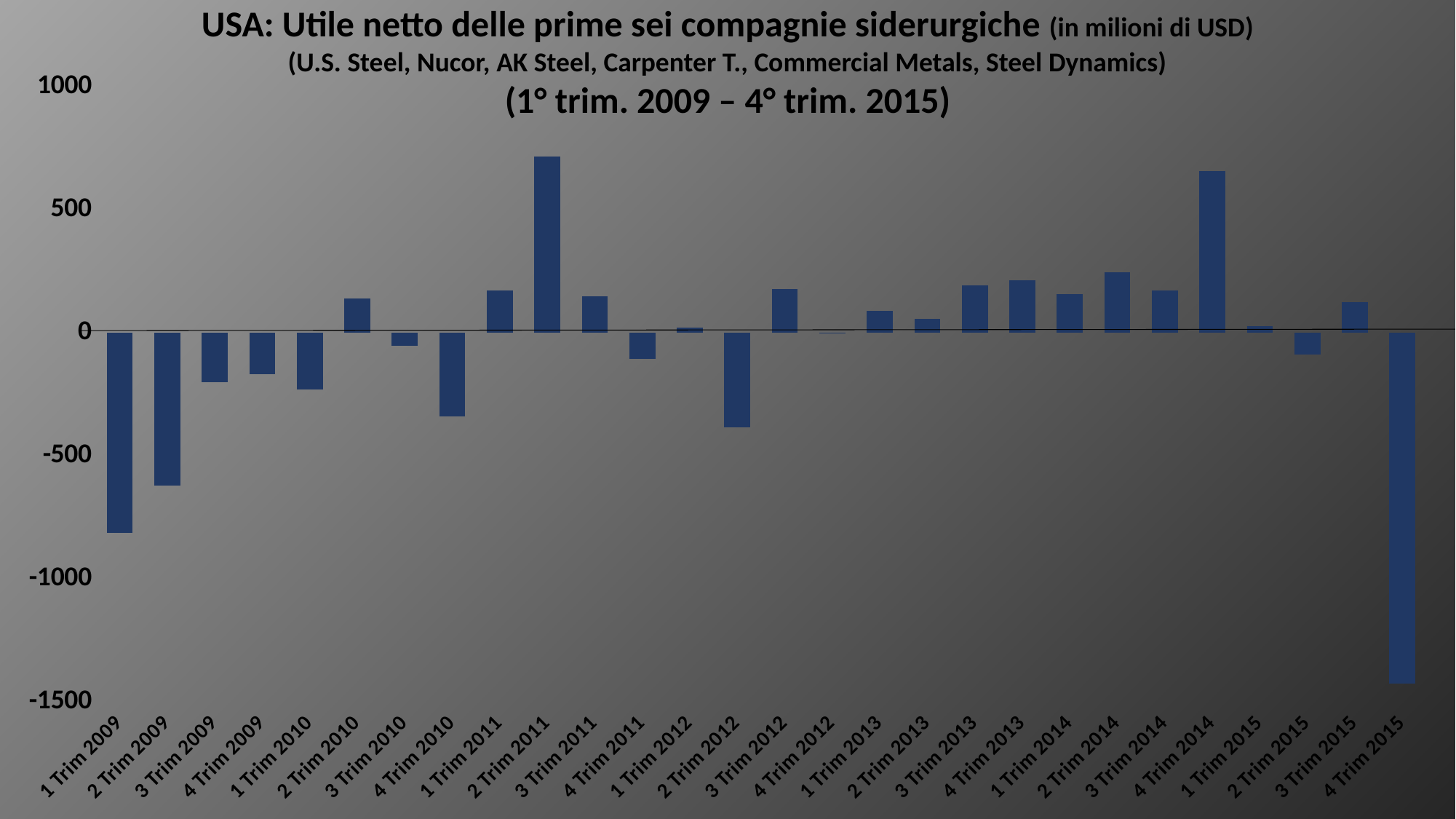
In what unit are the values on the chart expressed, according to the title? milioni di USD Across the four quarters of 2009, do the values rise or fall from 1 Trim 2009 to 4 Trim 2009? rise How many quarters (bars) are plotted on the chart? 28 What kind of chart is shown on the slide? bar chart Which is larger, the value for 1 Trim 2009 or the value for 2 Trim 2009? 2 Trim 2009 Which is larger, the value for 2 Trim 2011 or the value for 4 Trim 2014? 2 Trim 2011 Is the value for 1 Trim 2009 greater or less than -500? less Is the value for 2 Trim 2011 greater or less than 500? greater Is the value for 2 Trim 2012 greater or less than -500? greater Which quarter has the highest net profit on the chart? 2 Trim 2011 Which quarter has the lowest net profit on the chart? 4 Trim 2015